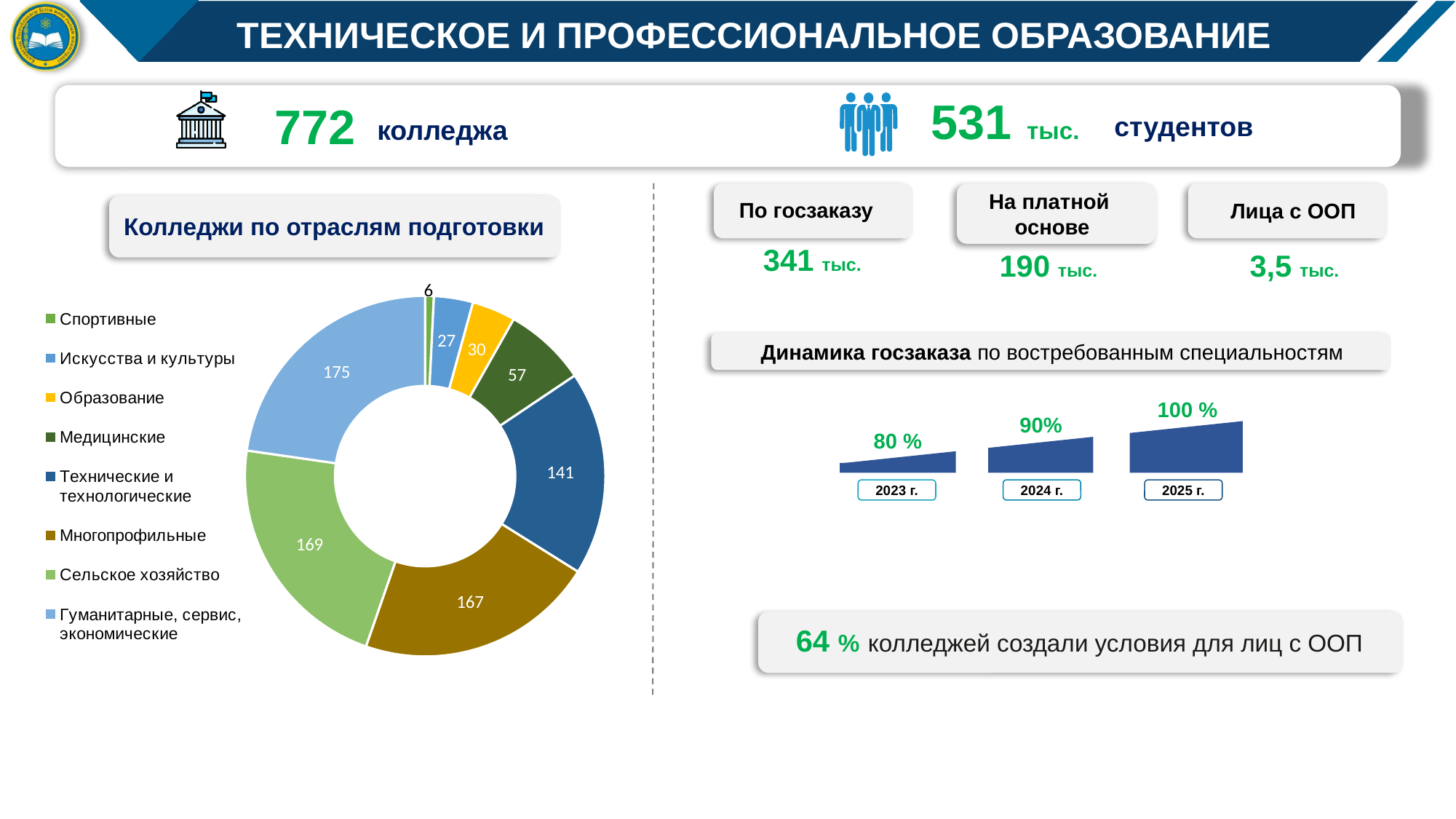
On the chart 'Динамика госзаказа по востребованным специальностям', do the values rise or fall from 2023 г. to 2025 г.? Rise On the chart 'Колледжи по отраслям подготовки', what is the value for Технические и технологические? 141 What kind of chart is 'Колледжи по отраслям подготовки'? Doughnut chart On the chart 'Колледжи по отраслям подготовки', what is the value for Образование? 30 On the chart 'Колледжи по отраслям подготовки', what is the value for Медицинские? 57 On the chart 'Колледжи по отраслям подготовки', which category has the highest value? Гуманитарные, сервис, экономические On the chart 'Колледжи по отраслям подготовки', what colour is the Образование segment? Yellow On the chart 'Динамика госзаказа по востребованным специальностям', what is the value for 2024 г.? 90% On the chart 'Колледжи по отраслям подготовки', which is larger: Сельское хозяйство or Многопрофильные? Сельское хозяйство On the chart 'Колледжи по отраслям подготовки', what is the difference between Многопрофильные and Технические и технологические? 26 How many categories does the chart 'Колледжи по отраслям подготовки' show? 8 On the chart 'Колледжи по отраслям подготовки', which category has the lowest value? Спортивные